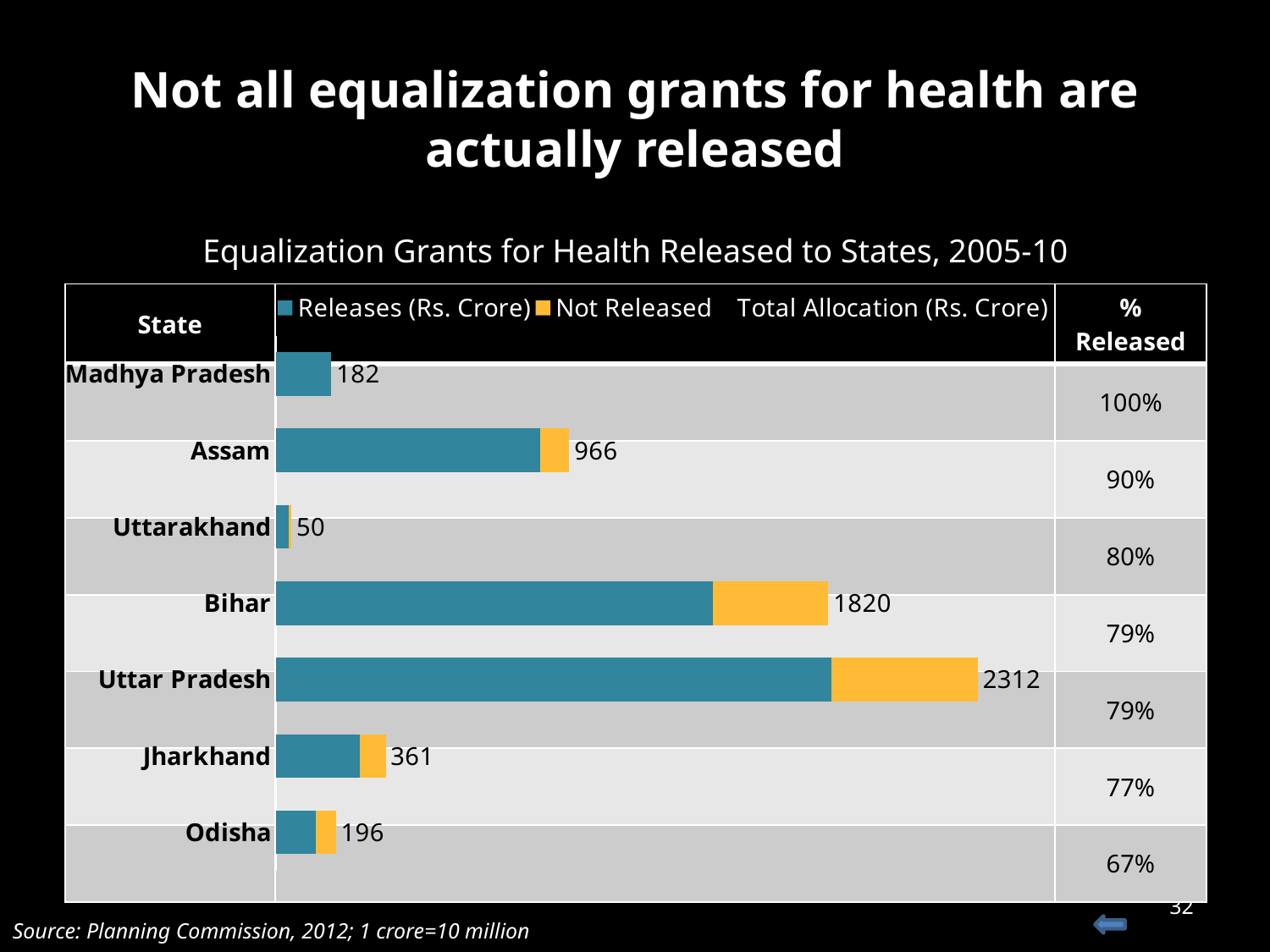
What kind of chart is shown on the slide? Bar chart What is the total allocation (Rs. Crore) shown for Assam? 966 How many states are shown in the chart? 7 What is the total allocation (Rs. Crore) shown for Uttar Pradesh? 2312 What is the difference in total allocation between Uttar Pradesh and Bihar? 492 What is the total allocation (Rs. Crore) shown for Bihar? 1820 What is the title of the chart? Equalization Grants for Health Released to States, 2005-10 Which state has the lowest total allocation? Uttarakhand Which state has the highest total allocation? Uttar Pradesh What is the total allocation (Rs. Crore) shown for Odisha? 196 Which state has a larger total allocation, Jharkhand or Odisha? Jharkhand How many series does the legend list? 3